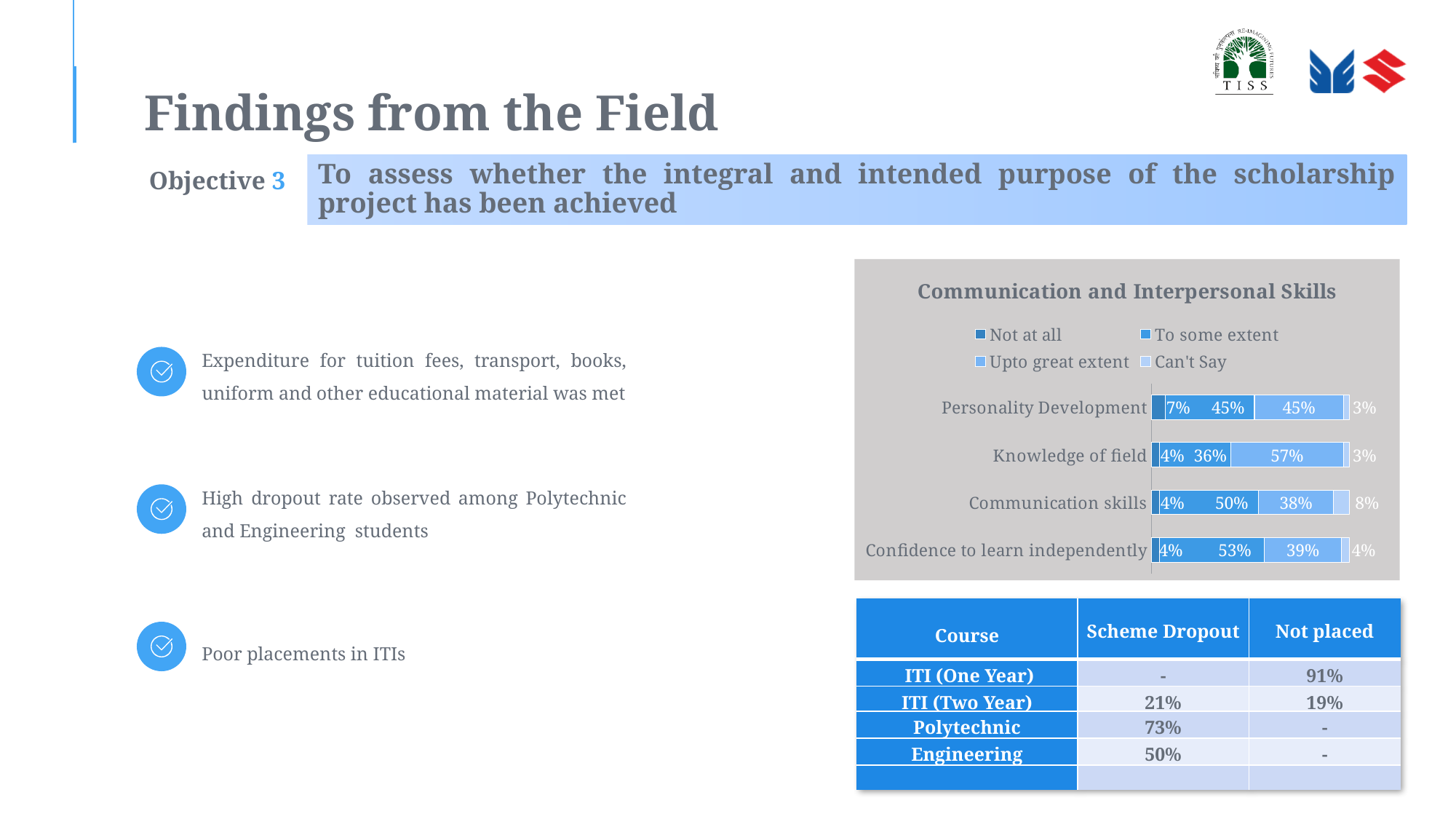
What is the title of the chart on the slide? Communication and Interpersonal Skills Which is larger: the 'Upto great extent' value for Personality Development or for Communication skills? Personality Development What kind of chart is shown on the slide? Stacked bar chart What is the 'To some extent' value for Confidence to learn independently? 53% What is the difference between the 'To some extent' values for Confidence to learn independently and Knowledge of field? 17% How many series does the chart's legend list? 4 What is the 'Can't Say' value for Communication skills? 8% Which category has the lowest 'To some extent' value? Knowledge of field What is the 'Not at all' value for Personality Development? 7% Which category has the highest 'Upto great extent' value? Knowledge of field How many categories are plotted in the chart? 4 What is the 'Upto great extent' value for Knowledge of field? 57%